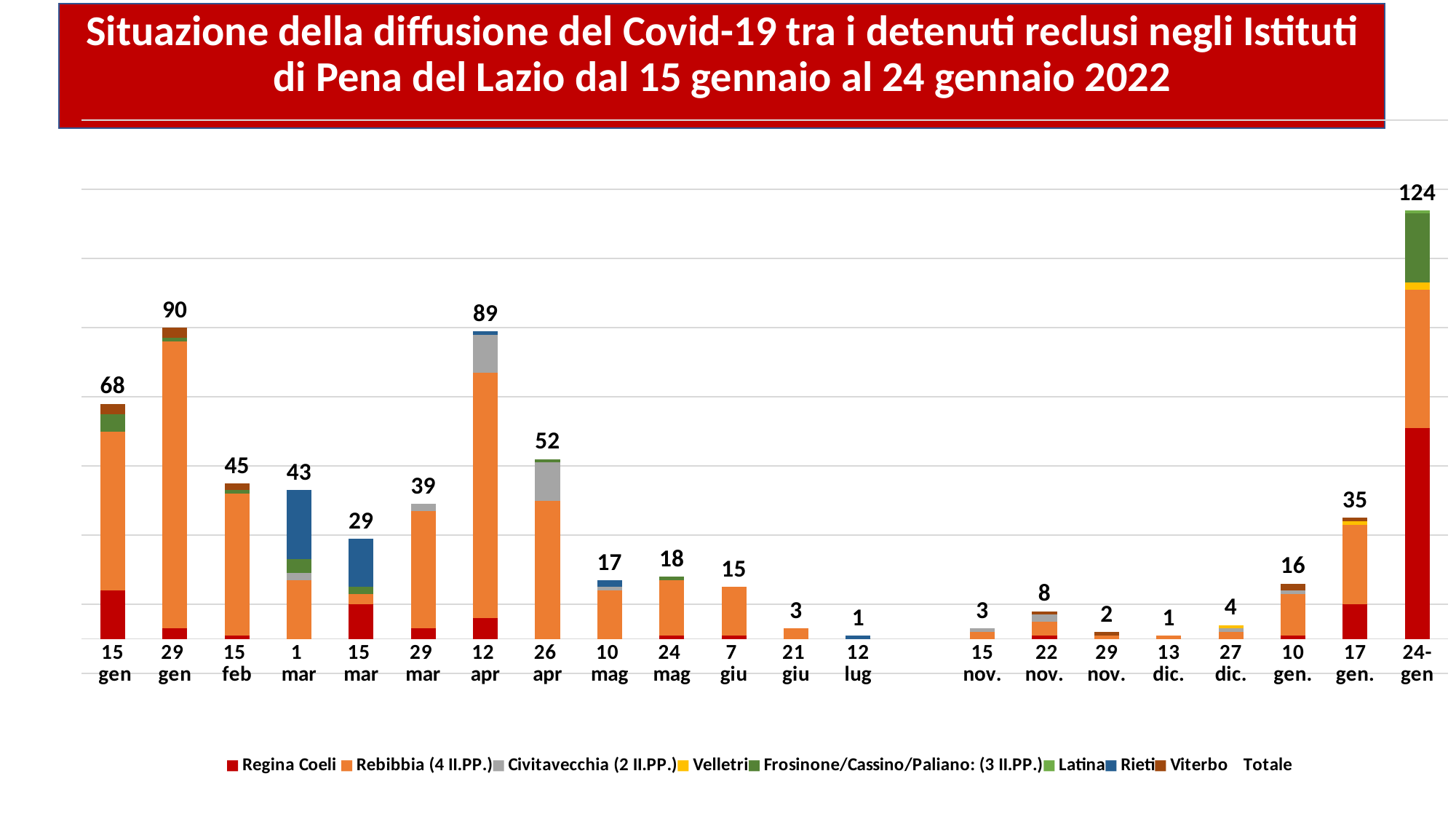
What is the total value shown for 29 gen? 90 Which date has the highest total? 24-gen How many entries does the legend list? 9 Which has a larger total, 17 gen. or 10 gen.? 17 gen. What is the total value shown for 12 apr? 89 What is the difference between the totals for 24-gen and 29 gen? 34 What is the total value shown for 24-gen? 124 Which has a larger total, 15 feb or 1 mar? 15 feb Which colour represents Regina Coeli in the legend? Red What kind of chart is shown? Stacked bar chart What is the total value shown for 22 nov.? 8 How many dates are shown on the x axis? 21